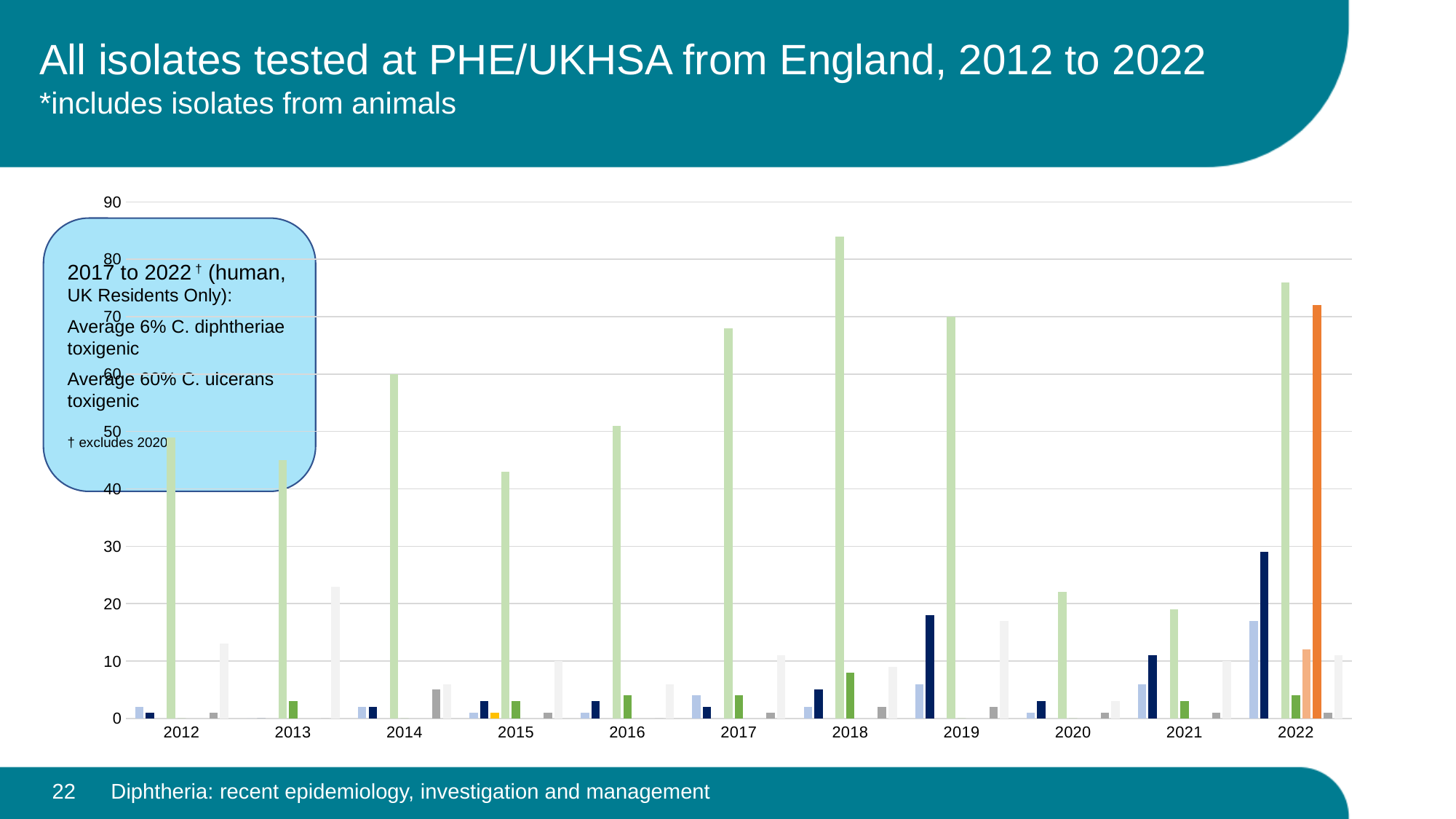
Is the light green bar for 2018 greater or less than 80? greater Which year has the taller light green bar, 2018 or 2022? 2018 Which year has the taller light green bar, 2014 or 2015? 2014 Is the dark navy bar for 2021 greater or less than 20? less Is the light green bar for 2020 greater or less than 30? less In which year is the light green bar the tallest? 2018 What is the highest value shown on the chart's y axis? 90 How many years are shown along the x axis of the chart? 11 What kind of chart is shown on the slide? bar chart What is the title of the slide containing the chart? All isolates tested at PHE/UKHSA from England, 2012 to 2022